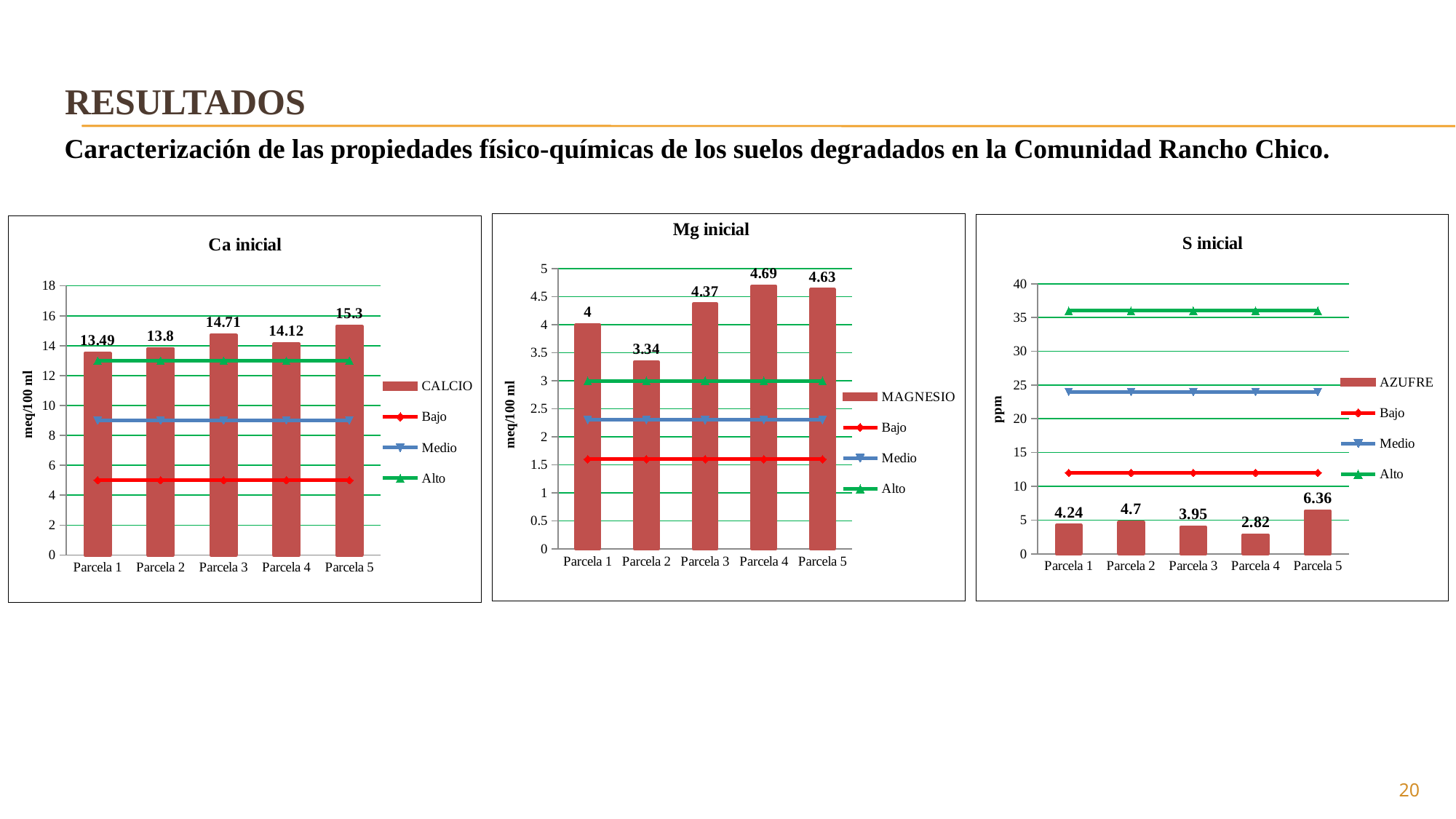
In the 'Ca inicial' chart, what is the CALCIO value for Parcela 3? 14.71 In the 'Mg inicial' chart, which parcela has the lowest MAGNESIO value? Parcela 2 In the 'Ca inicial' chart, is the Bajo line greater or less than 6? less In the 'Ca inicial' chart, which parcela has the highest CALCIO value? Parcela 5 In the 'Mg inicial' chart, what is the MAGNESIO value for Parcela 2? 3.34 In the 'S inicial' chart, which parcela has the highest AZUFRE value? Parcela 5 In the 'S inicial' chart, how many parcelas are shown on the x axis? 5 In the 'Ca inicial' chart, what is the difference between the CALCIO values for Parcela 5 and Parcela 1? 1.81 In the 'Mg inicial' chart, which is larger, the MAGNESIO value for Parcela 4 or Parcela 5? Parcela 4 In the 'S inicial' chart, what is the AZUFRE value for Parcela 4? 2.82 In the 'Mg inicial' chart, how many series does the legend list? 4 In the 'S inicial' chart, is the Alto line greater or less than 30? greater